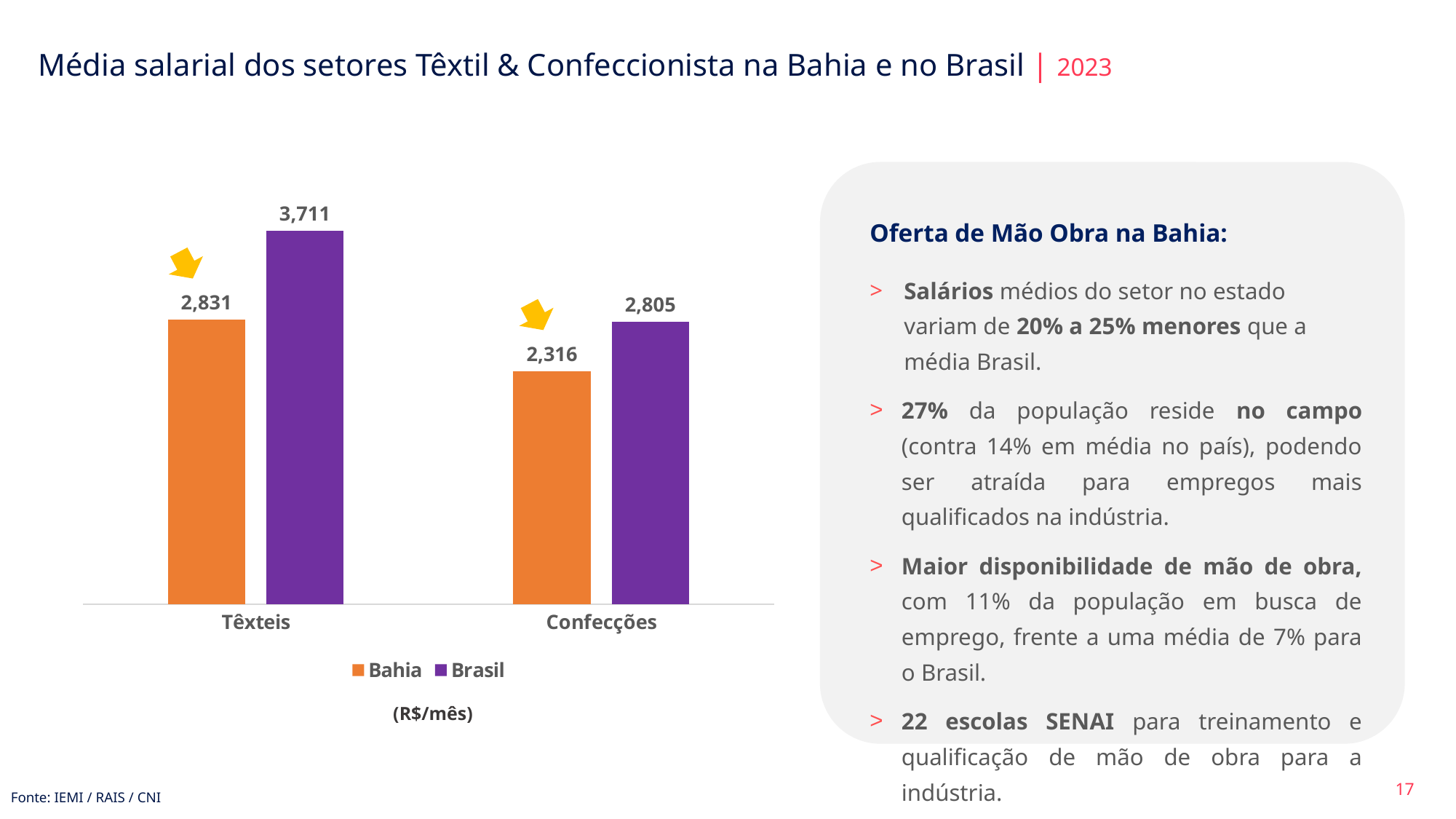
Which bar shows the lowest value on the chart? Bahia, Confecções What is the difference between the Brasil and Bahia values for Têxteis? 880 What is the average salary for Brasil in the Confecções category? 2,805 Which bar shows the highest value on the chart? Brasil, Têxteis How many series does the legend list? 2 What is the average salary for Bahia in the Têxteis category? 2,831 What kind of chart is shown on the slide? Bar chart What is the average salary for Bahia in the Confecções category? 2,316 Which is larger for Confecções: the Bahia value or the Brasil value? Brasil How many categories are shown on the x axis? 2 What is the average salary for Brasil in the Têxteis category? 3,711 What is the difference between the Brasil and Bahia values for Confecções? 489